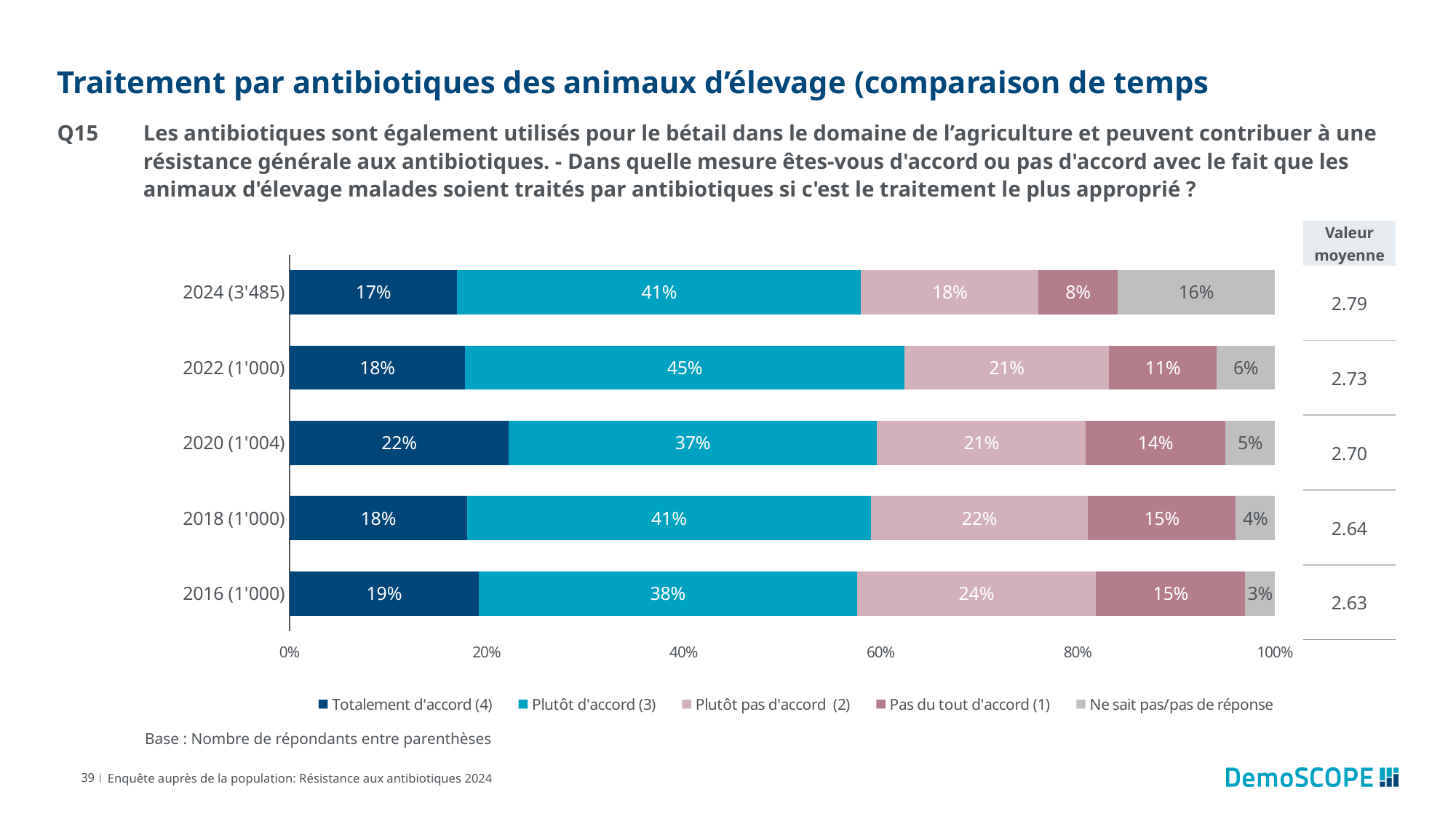
Which is larger: the "Pas du tout d'accord (1)" share in 2024 (3'485) or in 2018 (1'000)? 2018 (1'000) What is the "Ne sait pas/pas de réponse" share for 2024 (3'485)? 16% How many series does the legend list? 5 Which year has the lowest "Ne sait pas/pas de réponse" share? 2016 (1'000) What is the "Valeur moyenne" shown for 2018 (1'000)? 2.64 Which year has the highest "Totalement d'accord (4)" share? 2020 (1'004) What percentage of respondents in 2024 (3'485) answered "Totalement d'accord (4)"? 17% How many years (categories) are shown in the chart? 5 What percentage of respondents in 2016 (1'000) answered "Plutôt pas d'accord (2)"? 24% What kind of chart is shown on the slide? Stacked bar chart What percentage of respondents in 2022 (1'000) answered "Plutôt d'accord (3)"? 45% What is the difference between the "Plutôt d'accord (3)" share in 2022 (1'000) and in 2020 (1'004)? 8 percentage points